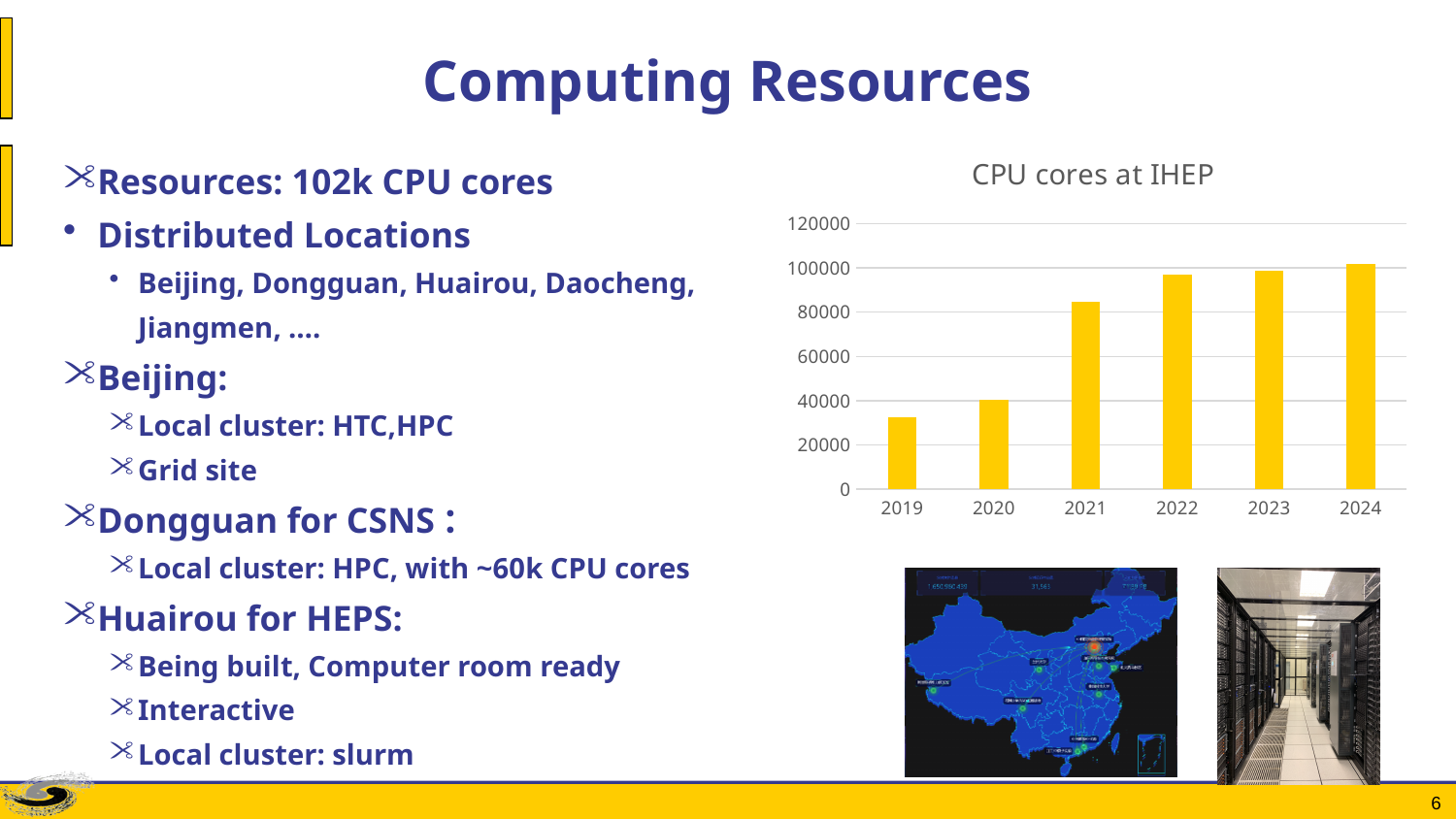
What colour are the bars in the CPU cores at IHEP chart? yellow What is the title of the chart on the slide? CPU cores at IHEP Is the value for 2024 greater or less than 100000? greater Is the value for 2022 greater or less than 100000? less Do the CPU core values rise or fall from 2019 to 2024? rise How many years are shown on the x axis of the CPU cores at IHEP chart? 6 Which year has more CPU cores, 2019 or 2021? 2021 Is the value for 2021 greater or less than 80000? greater Which year has the lowest number of CPU cores in the chart? 2019 What kind of chart is used to show CPU cores at IHEP? bar chart Which year has the highest number of CPU cores in the chart? 2024